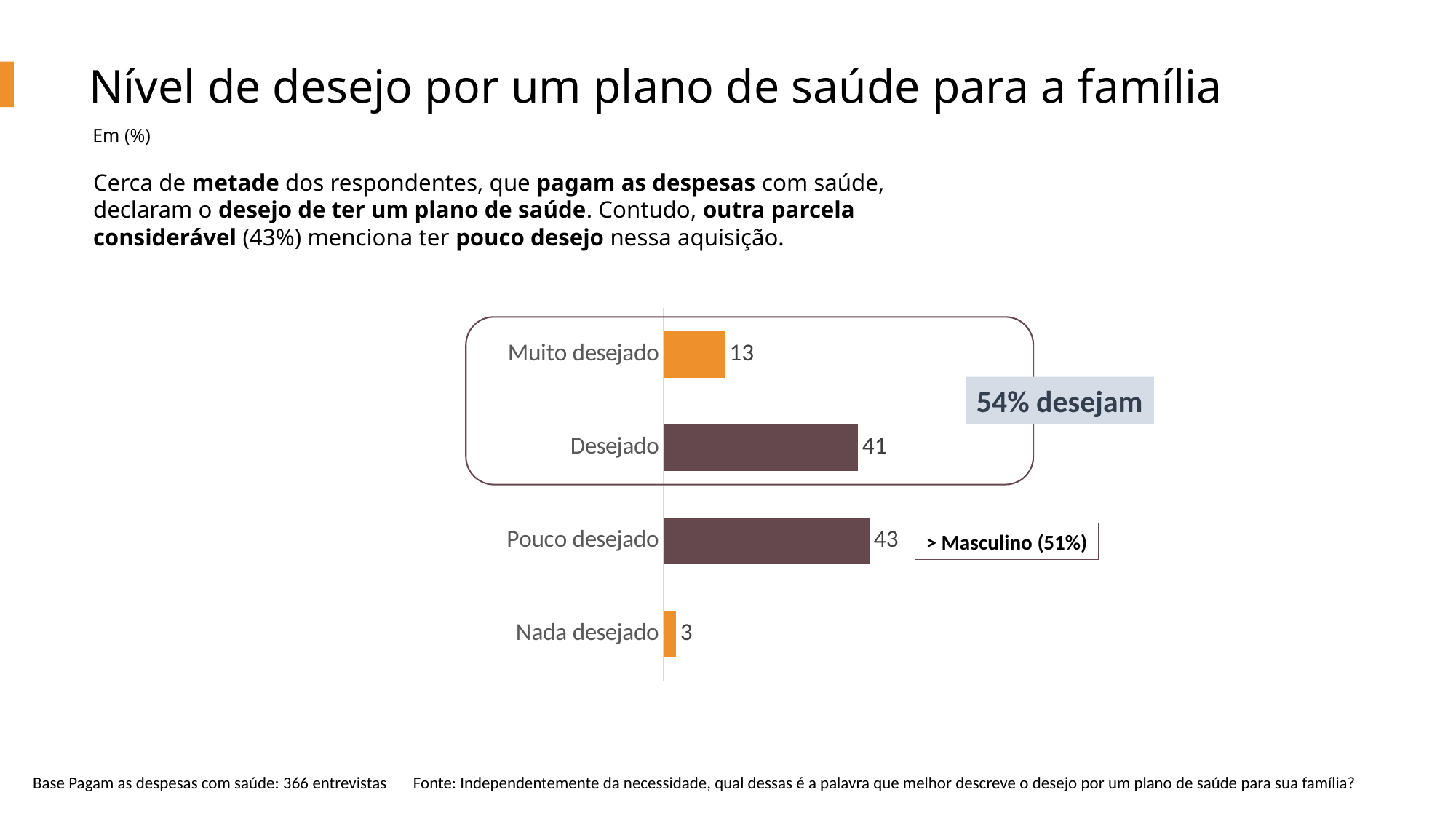
What kind of chart is shown on the slide? Bar chart What is the value for "Desejado"? 41 Which category has the highest value? Pouco desejado What is the value for "Muito desejado"? 13 How many categories are shown in the chart? 4 Which category has the lowest value? Nada desejado What is the value for "Pouco desejado"? 43 What is the combined value of "Muito desejado" and "Desejado"? 54 What is the difference between the values for "Pouco desejado" and "Muito desejado"? 30 What percentage is shown in the highlighted box next to the top two bars? 54% desejam Which is larger, the value for "Desejado" or the value for "Muito desejado"? Desejado What is the value for "Nada desejado"? 3